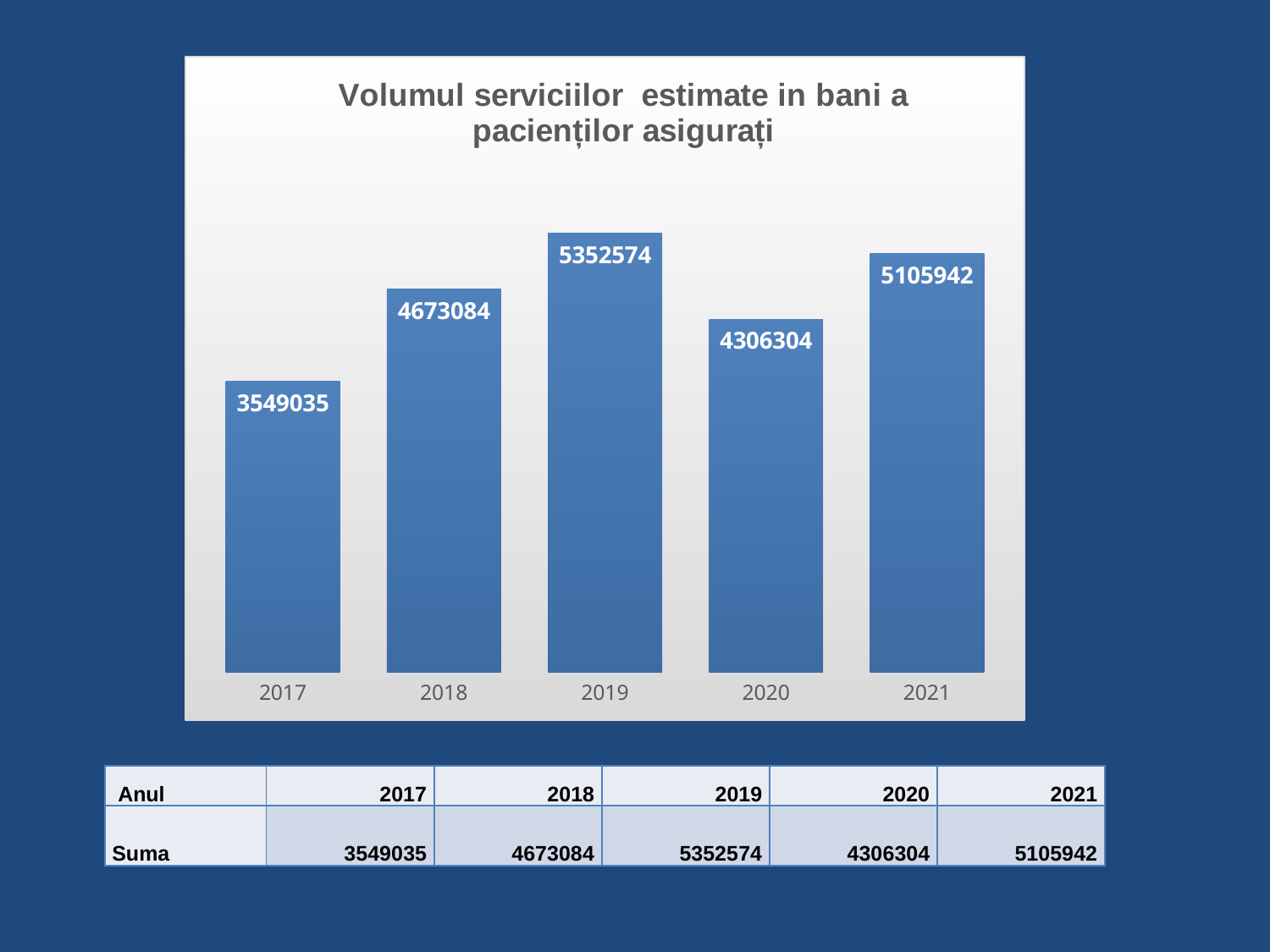
What is the difference between the values for 2019 and 2017? 1803539 What is the title of the chart? Volumul serviciilor estimate in bani a pacienților asigurați Which is larger, the value for 2018 or the value for 2020? 2018 Which year has the lowest value? 2017 What kind of chart is shown? bar chart What is the value for 2021? 5105942 What is the value for 2017? 3549035 What is the value for 2020? 4306304 How many years are shown on the x axis? 5 Does the value rise or fall from 2019 to 2020? fall Which year has the highest value? 2019 What is the difference between the values for 2021 and 2020? 799638